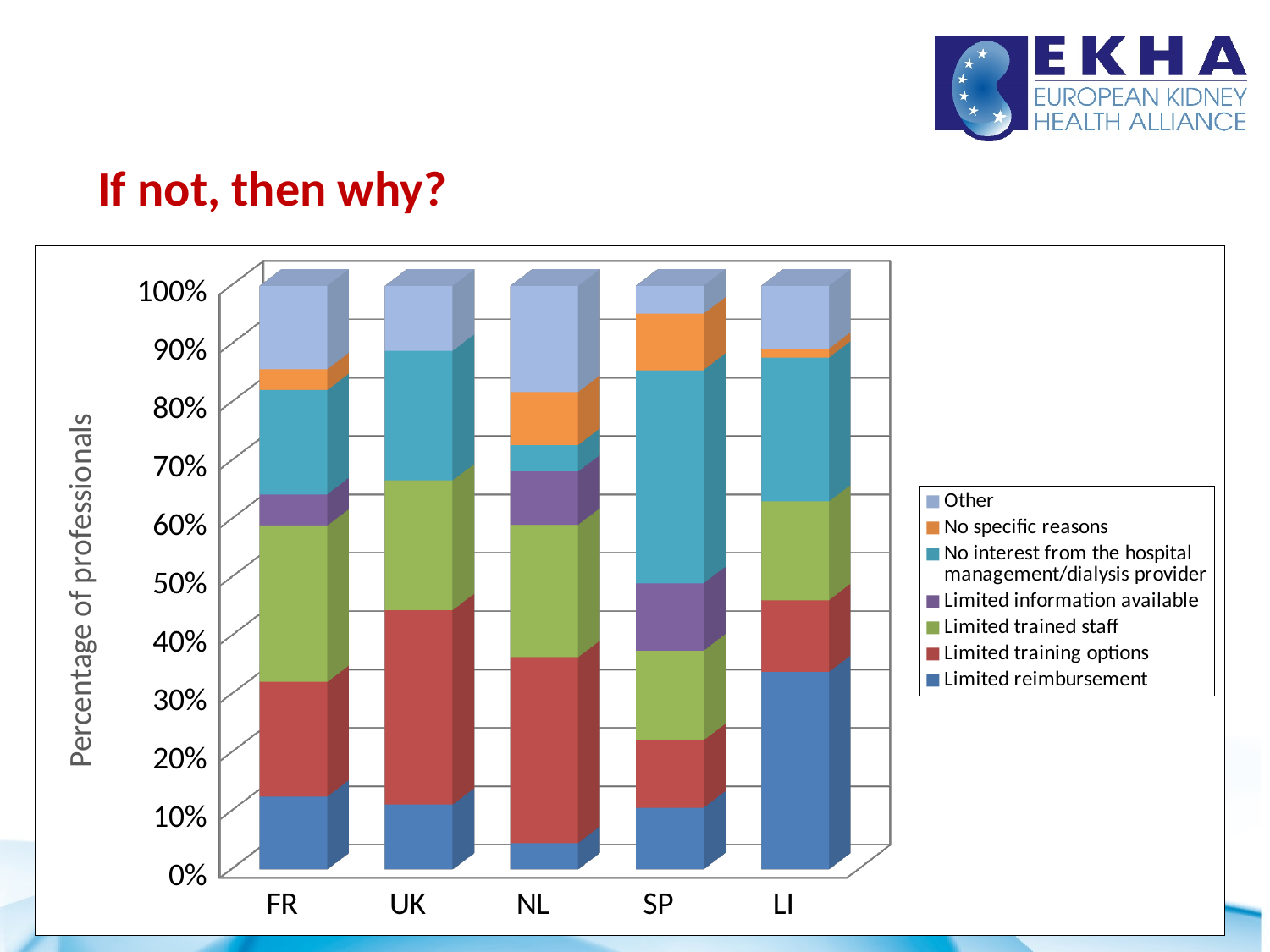
Is the 'Limited reimbursement' value for NL greater or less than 10%? less What kind of chart is shown on the slide? Stacked bar chart Which country has the largest 'No interest from the hospital management/dialysis provider' segment? SP What is the title of the slide above the chart? If not, then why? Is the 'Limited information available' segment larger for SP or for FR? SP Which country has the largest 'Limited reimbursement' segment? LI Is the 'Limited reimbursement' segment larger for LI or for NL? LI Is the 'Limited reimbursement' value for LI greater or less than 20%? greater How many series does the chart legend list? 7 Which country has the smallest 'Limited reimbursement' segment? NL How many countries are shown on the x axis of the chart? 5 What is the label of the vertical axis of the chart? Percentage of professionals